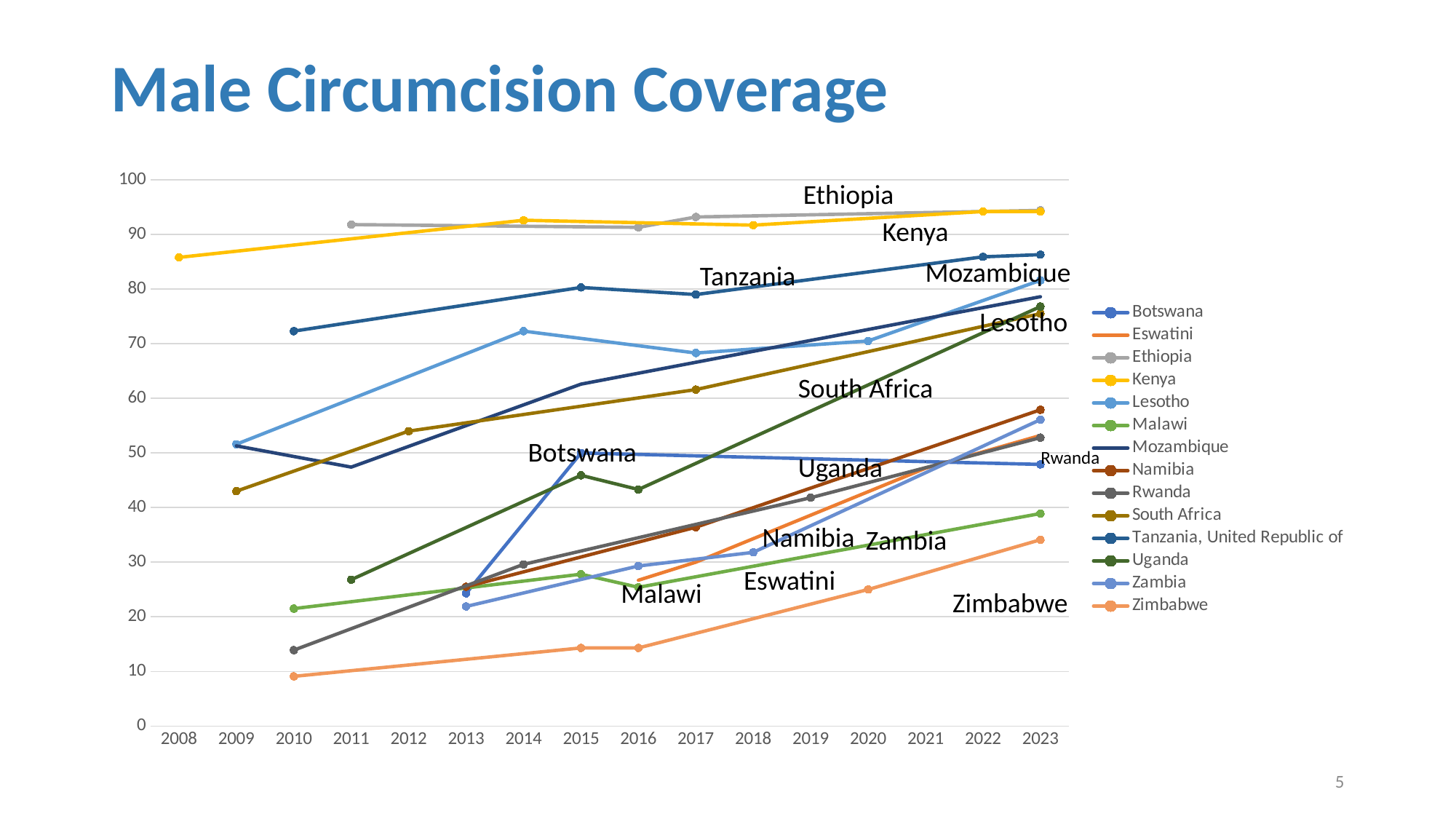
What is the title of the slide? Male Circumcision Coverage Is the value for Uganda in 2023 greater or less than 70? greater How many series does the legend list? 14 How many years are labelled on the x axis? 16 Is the value for Tanzania, United Republic of in 2010 greater or less than 70? greater Is the value for Eswatini in 2016 greater or less than 20? greater Which is higher in 2023, Tanzania, United Republic of or Mozambique? Tanzania, United Republic of What kind of chart is shown on the slide? line chart Does the Zimbabwe series rise or fall from 2010 to 2023? rise Which series has the lowest value in 2023? Zimbabwe